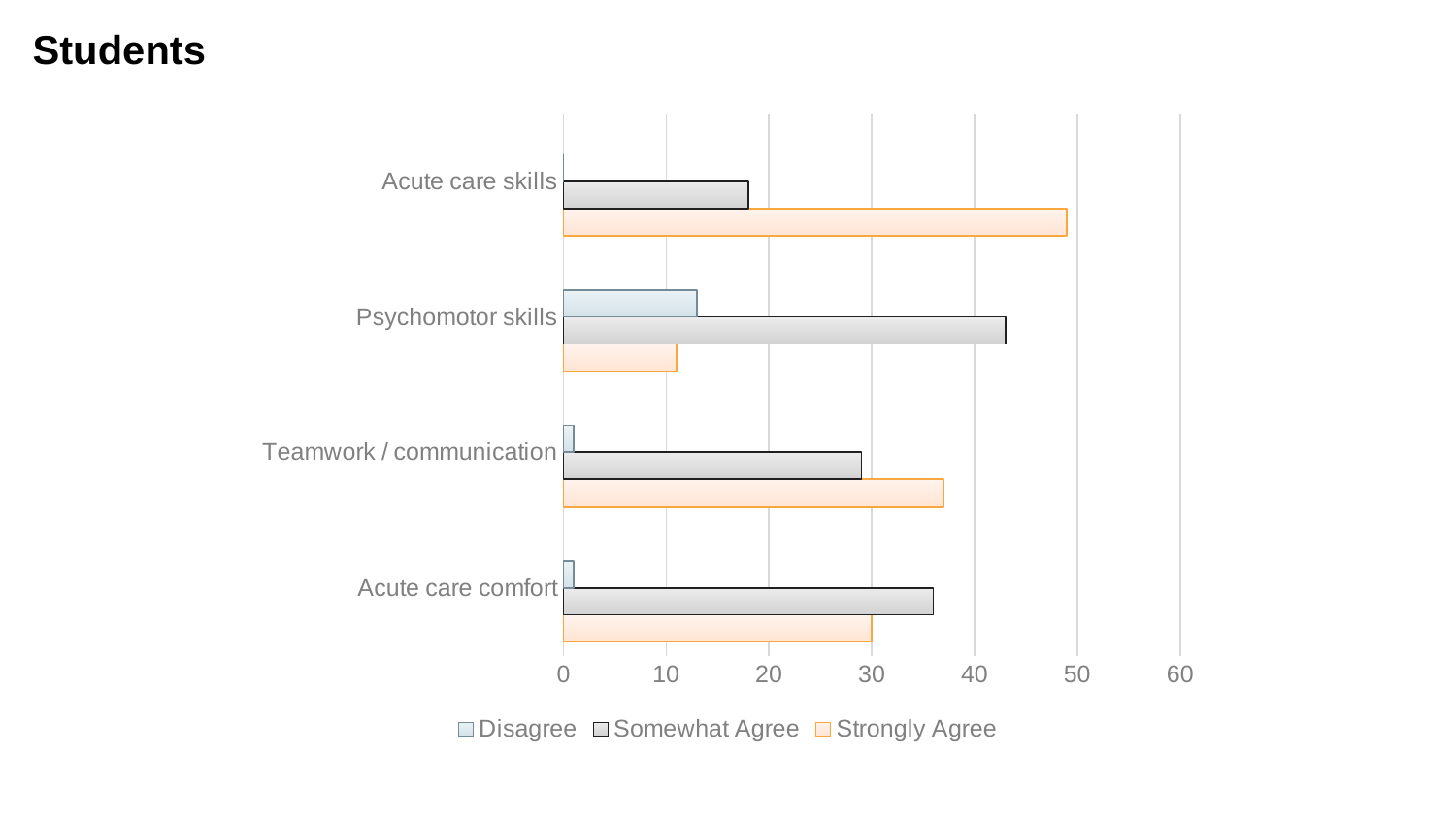
For Teamwork / communication, which is larger: Somewhat Agree or Strongly Agree? Strongly Agree What kind of chart is shown on the slide? bar chart Which category has the lowest Strongly Agree value? Psychomotor skills Is the Somewhat Agree value for Acute care skills greater or less than 20? less How many categories are shown on the chart? 4 Is the Disagree value for Psychomotor skills greater or less than 10? greater Which category has the highest Strongly Agree value? Acute care skills Is the Strongly Agree value for Acute care skills greater or less than 40? greater Which category has the highest Disagree value? Psychomotor skills How many series does the legend list? 3 Which category has the highest Somewhat Agree value? Psychomotor skills What is the title of the slide? Students